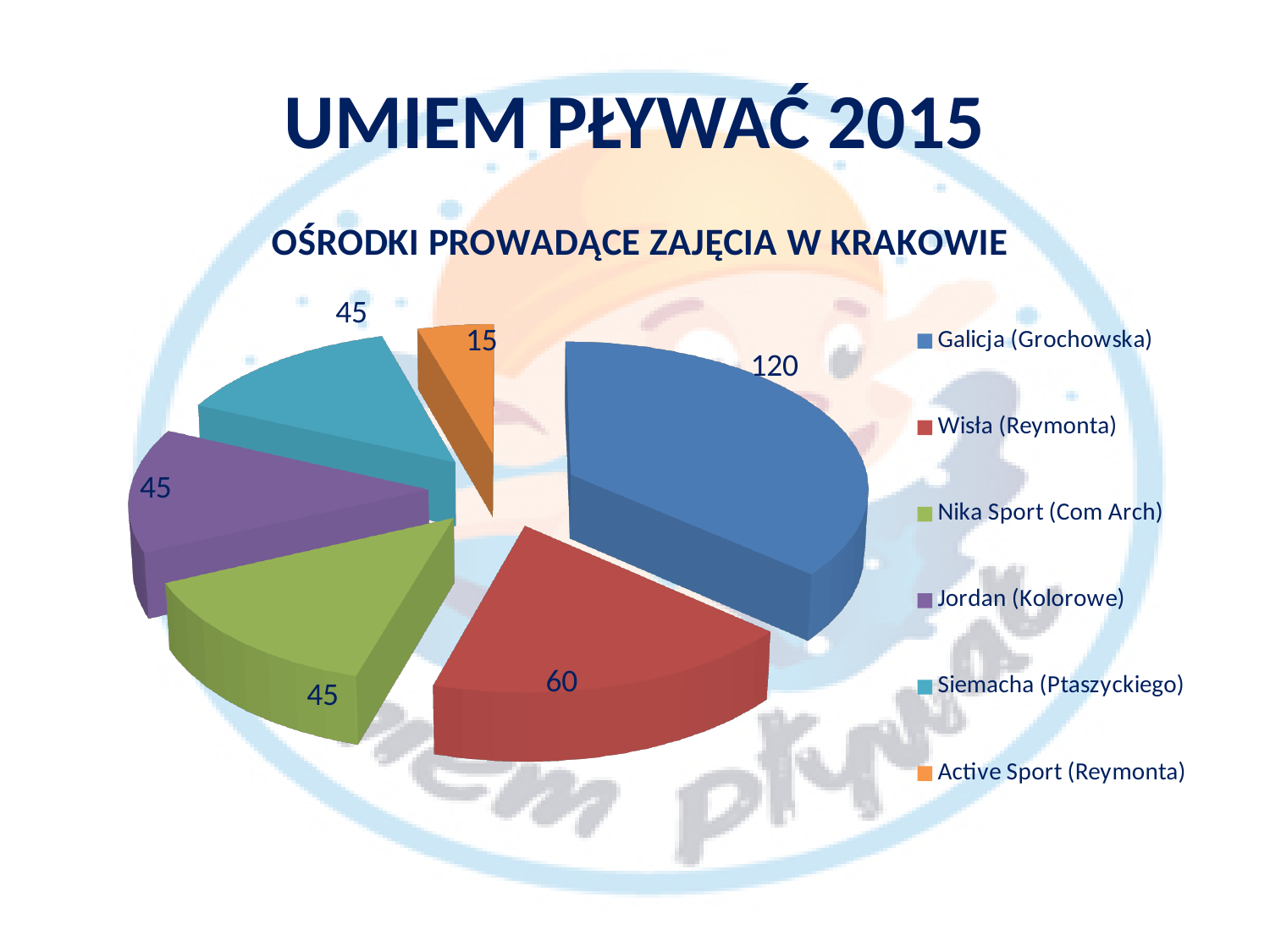
What is the total of all the values shown in the pie chart? 330 What is the value for Wisła (Reymonta)? 60 Which is larger, the value for Wisła (Reymonta) or the value for Siemacha (Ptaszyckiego)? Wisła (Reymonta) What is the difference between the values for Galicja (Grochowska) and Wisła (Reymonta)? 60 What is the value for Galicja (Grochowska)? 120 How many centres (slices) are shown in the pie chart? 6 What type of chart is shown on the slide? Pie chart Which centre has the smallest slice of the pie? Active Sport (Reymonta) What is the value for Active Sport (Reymonta)? 15 Which centre has the largest slice of the pie? Galicja (Grochowska) What is the title of the chart? OŚRODKI PROWADĄCE ZAJĘCIA W KRAKOWIE What is the value for Jordan (Kolorowe)? 45